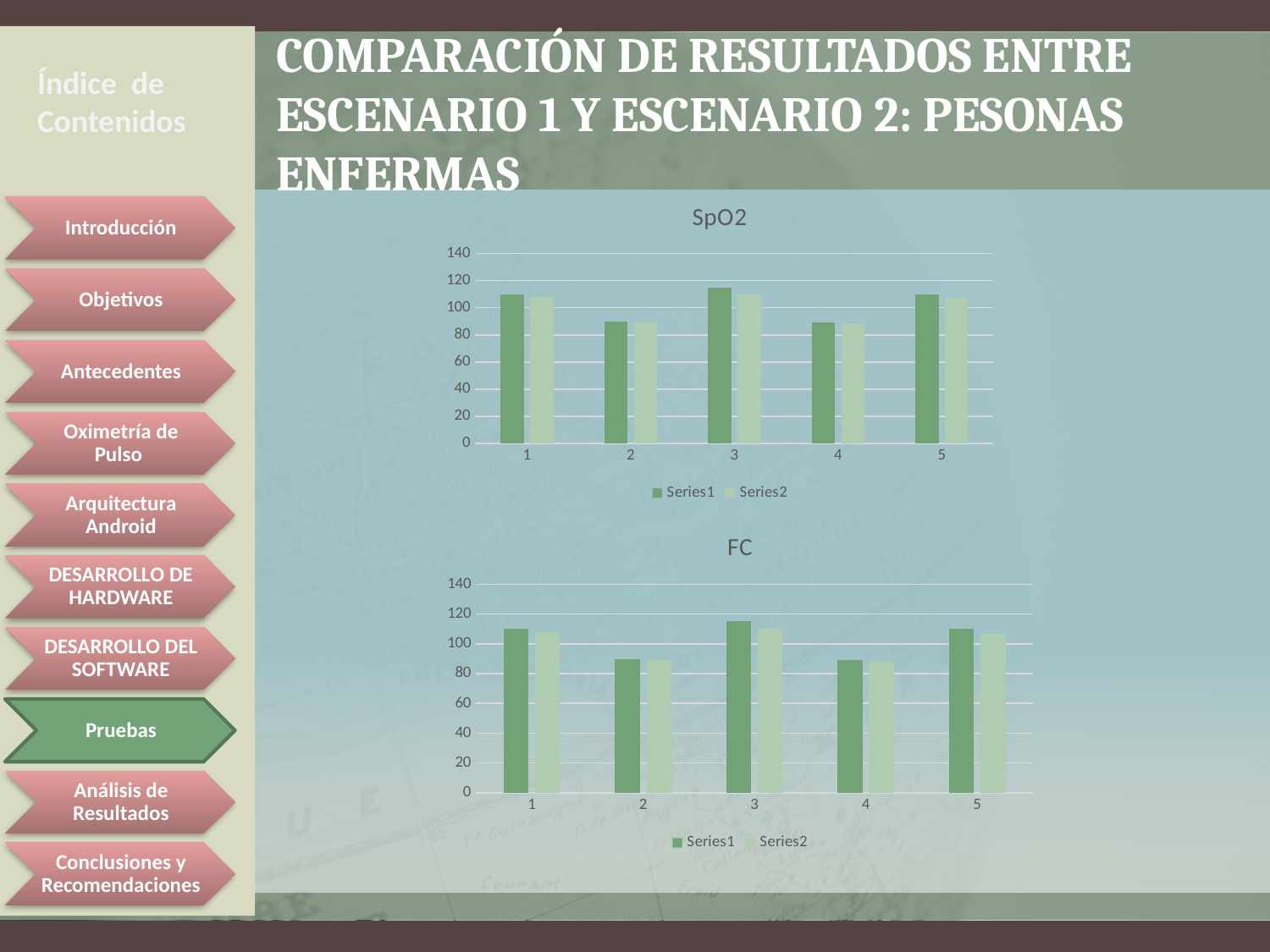
In the FC chart, is the Series2 value for category 4 greater or less than 100? less How many categories are shown on the x axis of the SpO2 chart? 5 In the SpO2 chart, which is larger for Series1: category 1 or category 2? category 1 In the FC chart, which is larger for Series2: category 3 or category 4? category 3 How many series does the legend of the FC chart list? 2 In the SpO2 chart, is the Series1 value for category 3 greater or less than 100? greater In the FC chart, which category has the highest Series1 value? 3 In the FC chart, is the Series1 value for category 5 greater or less than 120? less What is the title of the lower chart on the slide? FC What kind of chart is the SpO2 chart? bar chart In the SpO2 chart, which category has the highest Series1 value? 3